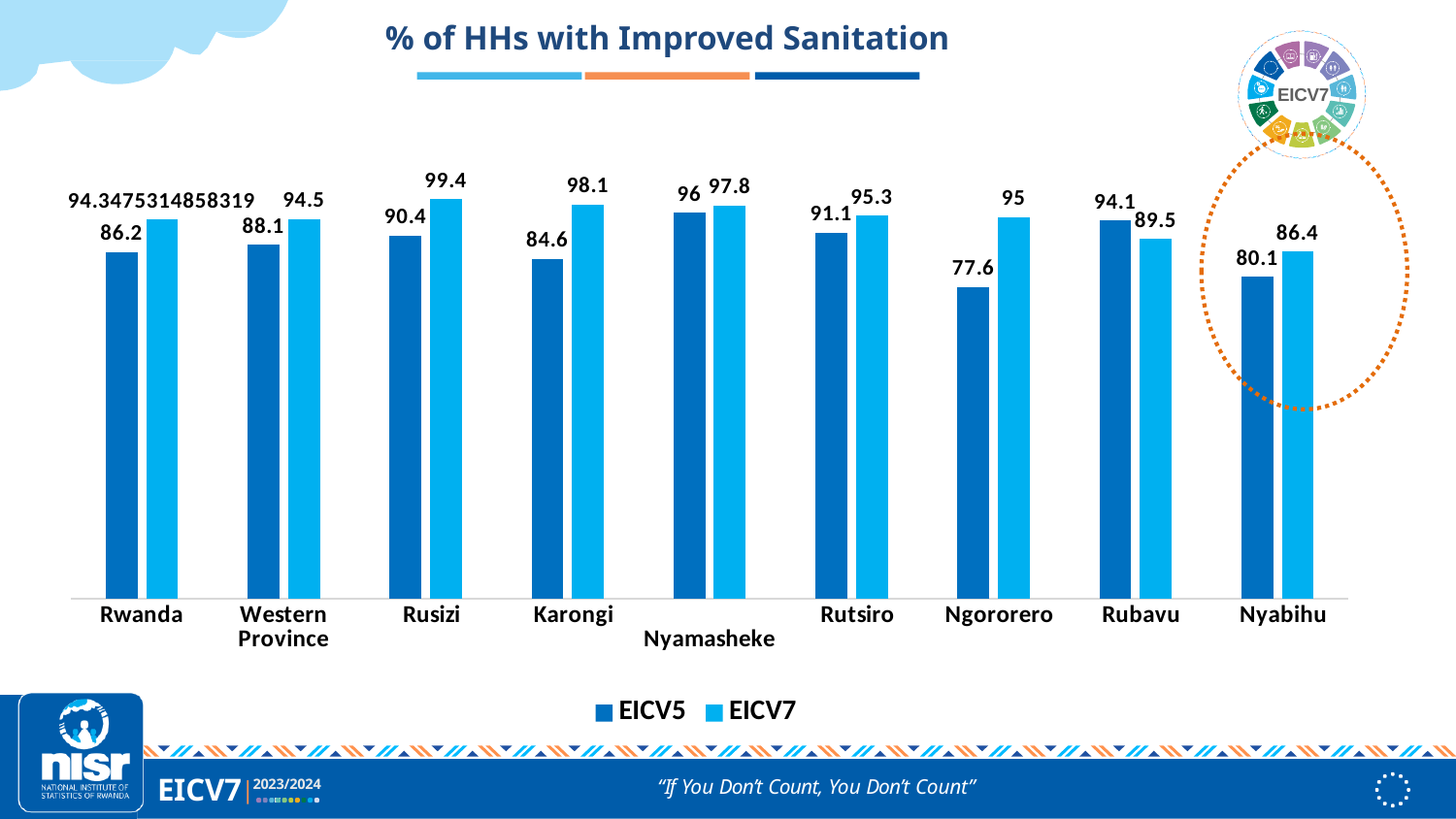
Which category has the lowest EICV5 value? Ngororero For Rubavu, which series has the larger value, EICV5 or EICV7? EICV5 What is the EICV7 value for Rusizi? 99.4 What is the difference between the EICV7 and EICV5 values for Karongi? 13.5 How many series does the legend list? 2 Which category has the lowest EICV7 value? Nyabihu Which category has the highest EICV7 value? Rusizi What is the difference between the EICV7 and EICV5 values for Ngororero? 17.4 What is the EICV5 value for Ngororero? 77.6 What kind of chart is shown on the slide? Bar chart How many categories are shown on the x axis? 9 What is the EICV7 value for Nyabihu? 86.4